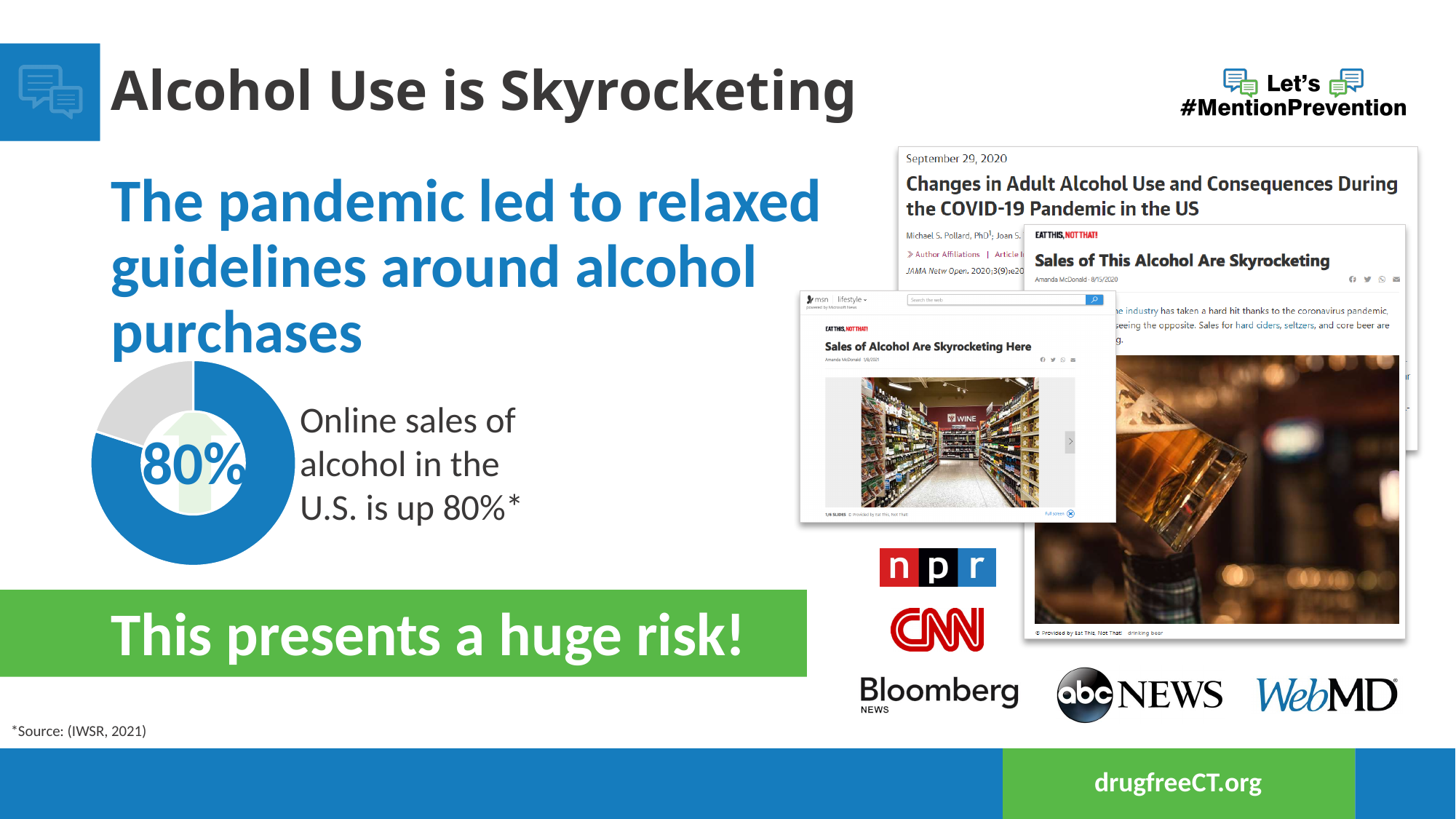
What kind of chart is shown on the left of the slide? Pie (donut) chart What percentage is printed in the centre of the donut chart? 80% What source is cited for the 80% figure shown in the donut chart? IWSR, 2021 What share of the donut chart is not covered by the blue 80% segment? 20% What share of the donut chart does the blue segment represent? 80% What does the 80% in the donut chart represent, according to the text beside it? Online sales of alcohol in the U.S. is up 80% Is the blue segment of the donut chart greater or less than 50% of the chart? greater What colour is the segment of the donut chart that represents 80%? Blue